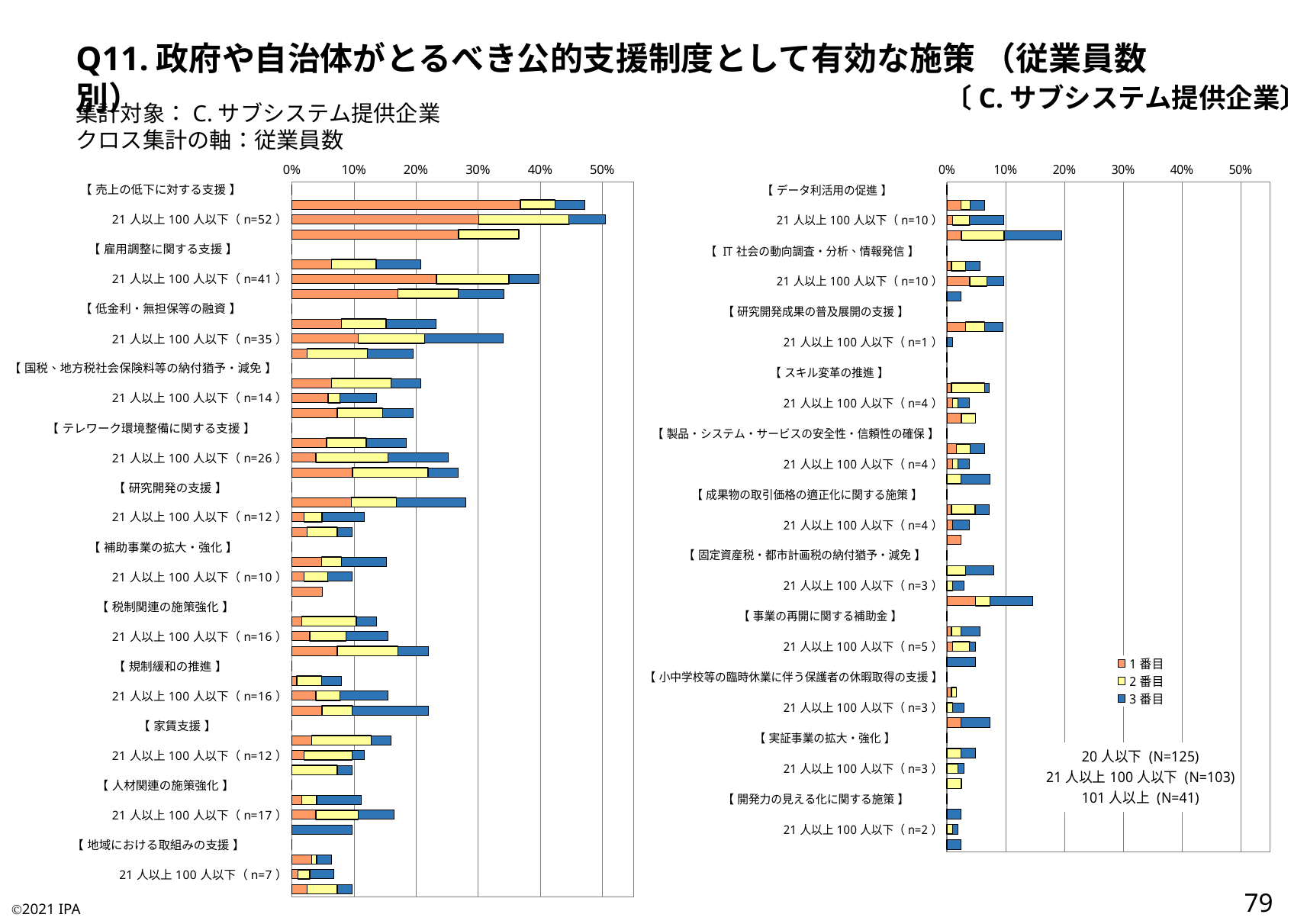
In the left chart, is the total bar for 21人以上100人以下 (n=7) under 地域における取組みの支援 greater or less than 10%? less What is the maximum value shown on the horizontal axis of the left chart? 50% In the left chart, which is larger: the total bar for 21人以上100人以下 (n=52) under 売上の低下に対する支援 or the total bar for 21人以上100人以下 (n=7) under 地域における取組みの支援? 売上の低下に対する支援 (n=52) How many category groups (bracketed headings) are shown in the right chart? 11 In the left chart, among the bars labeled 21人以上100人以下, which category has the longest total bar? 売上の低下に対する支援 In the left chart, is the total bar for 21人以上100人以下 (n=52) under 売上の低下に対する支援 greater or less than 40%? greater In the right chart, is the total bar for 21人以上100人以下 (n=5) under 事業の再開に関する補助金 greater or less than 10%? less What kind of chart is the left chart on the slide? Stacked horizontal bar chart How many category groups (bracketed headings) are shown in the left chart? 12 How many series does the legend on the right chart list? 3 What are the legend entries shown on the right chart? 1番目, 2番目, 3番目